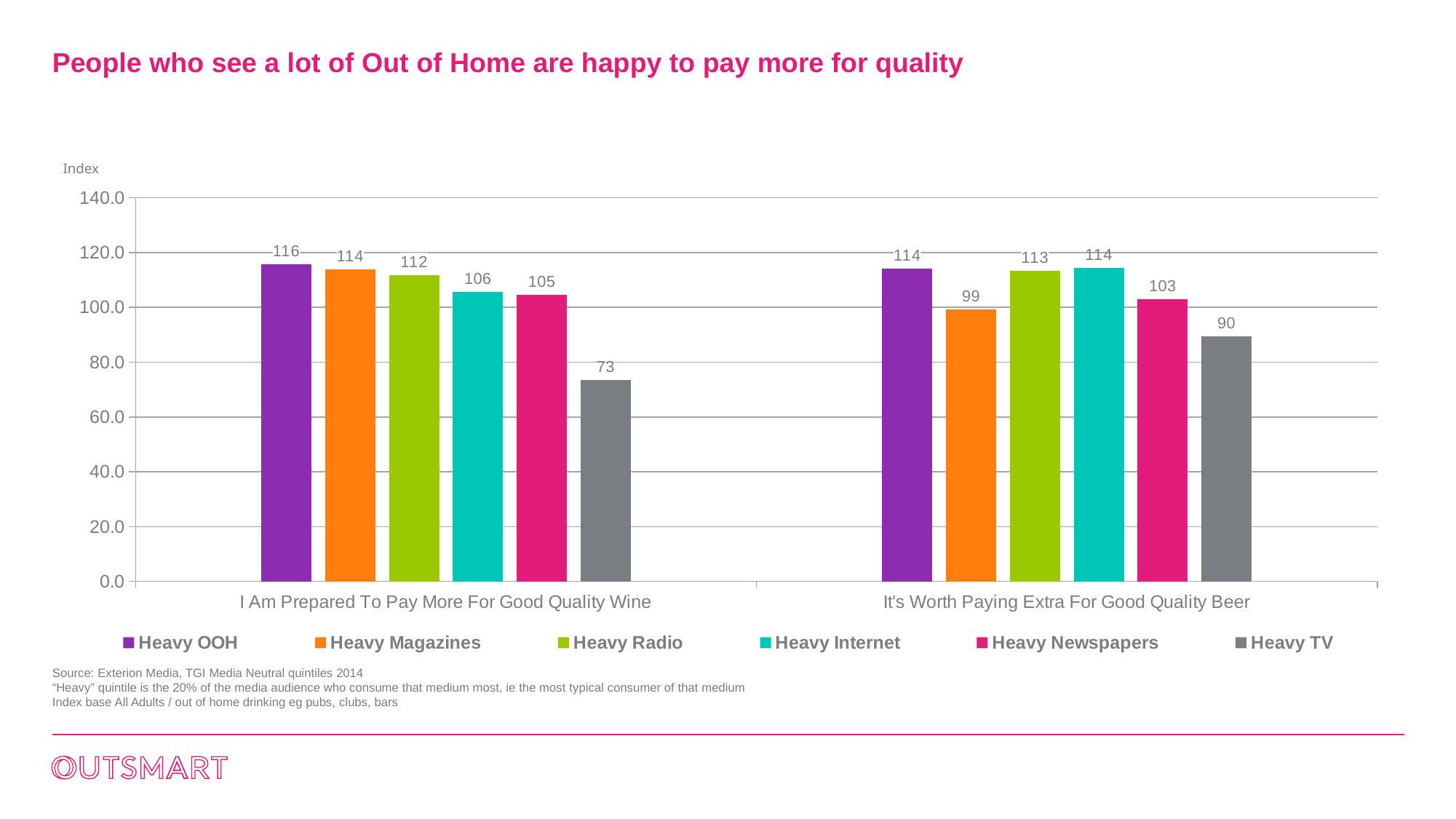
What is the Heavy Magazines index for 'It's Worth Paying Extra For Good Quality Beer'? 99 How many categories are shown on the x axis? 2 What kind of chart is shown on the slide? Bar chart Which series has the lowest index for 'I Am Prepared To Pay More For Good Quality Wine'? Heavy TV What is the Heavy TV index for 'It's Worth Paying Extra For Good Quality Beer'? 90 What is the difference between the Heavy OOH and Heavy TV indices for 'I Am Prepared To Pay More For Good Quality Wine'? 43 Which series has the highest index for 'I Am Prepared To Pay More For Good Quality Wine'? Heavy OOH What is the difference between the Heavy Newspapers and Heavy Magazines indices for 'It's Worth Paying Extra For Good Quality Beer'? 4 What is the Heavy OOH index for 'I Am Prepared To Pay More For Good Quality Wine'? 116 Is the Heavy TV index for 'I Am Prepared To Pay More For Good Quality Wine' greater or less than 80? less How many series does the legend list? 6 For 'It's Worth Paying Extra For Good Quality Beer', which is larger: Heavy Radio or Heavy Magazines? Heavy Radio